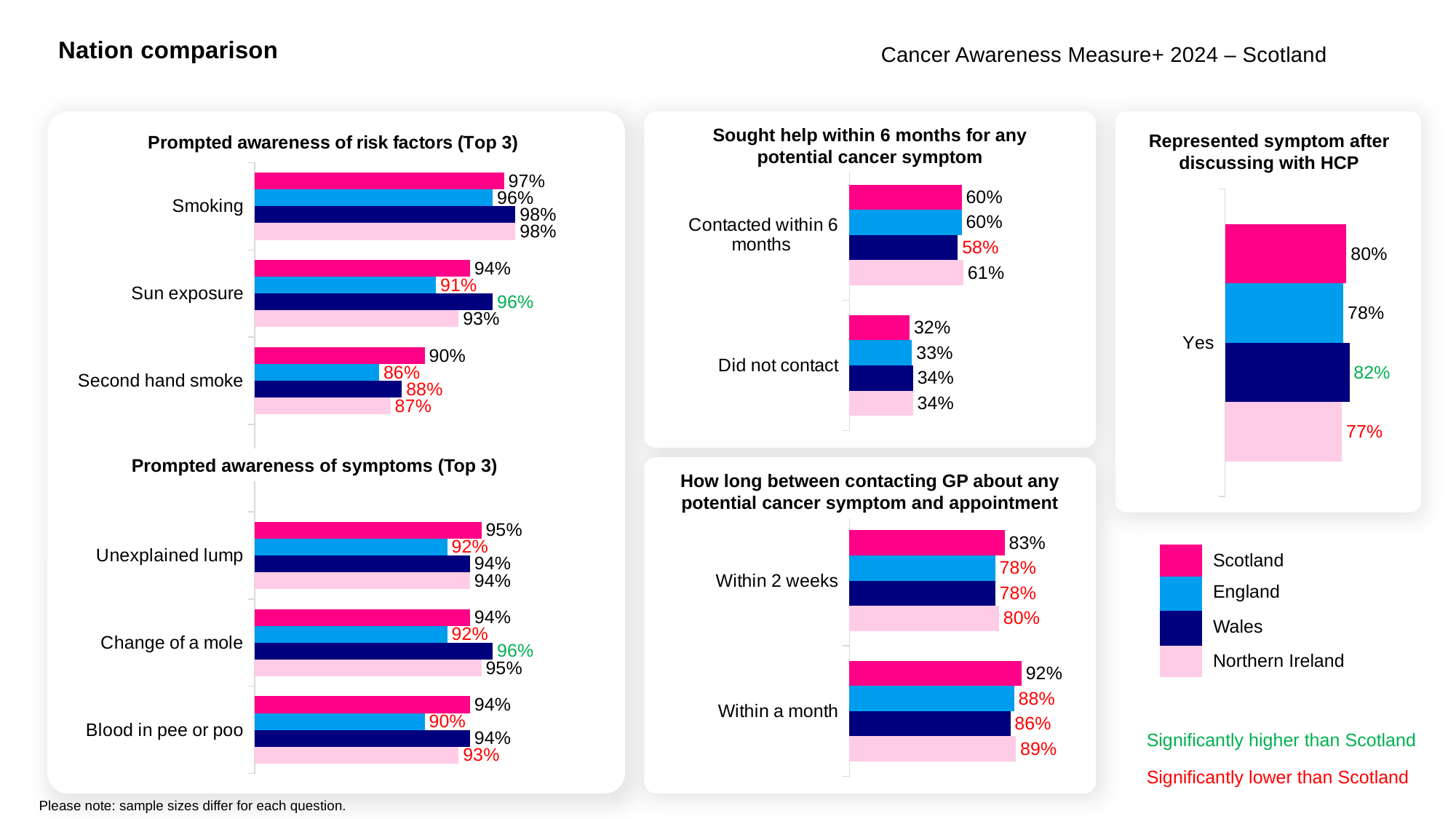
In the 'How long between contacting GP about any potential cancer symptom and appointment' chart, which nation has the highest value for Within 2 weeks? Scotland In the 'Prompted awareness of symptoms (Top 3)' chart, what is the value for England for Blood in pee or poo? 90% In the 'How long between contacting GP about any potential cancer symptom and appointment' chart, what is the difference between the Scotland and Wales values for Within a month? 6% In the 'Prompted awareness of risk factors (Top 3)' chart, what is the value for Wales for Sun exposure? 96% In the 'Represented symptom after discussing with HCP' chart, which nation has the lowest value? Northern Ireland In the 'Sought help within 6 months for any potential cancer symptom' chart, what is the value for Scotland for Did not contact? 32% In the 'Prompted awareness of risk factors (Top 3)' chart, which nation has the lowest value for Second hand smoke? England In the 'Prompted awareness of symptoms (Top 3)' chart, which nation has the highest value for Change of a mole? Wales In the 'Represented symptom after discussing with HCP' chart, is the value for Wales larger or smaller than the value for England? larger How many series does the legend list? 4 In the 'Prompted awareness of symptoms (Top 3)' chart, what is the difference between the Scotland and England values for Unexplained lump? 3% In the 'Sought help within 6 months for any potential cancer symptom' chart, what is the value for Northern Ireland for Contacted within 6 months? 61%